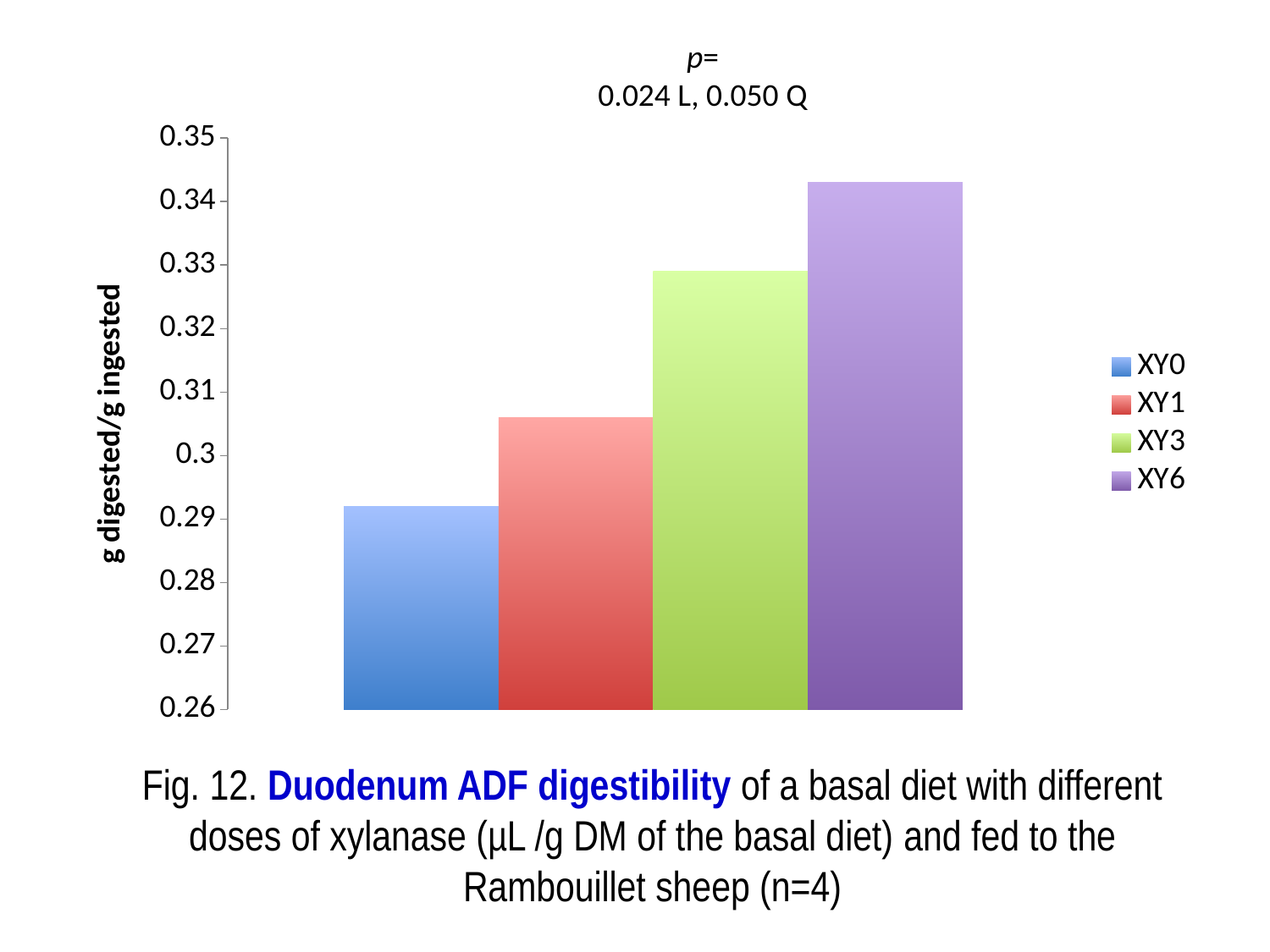
Which series has the highest duodenum ADF digestibility? XY6 How many series does the legend list? 4 Is the value for XY0 greater or less than 0.30? less Is the value for XY3 greater or less than 0.32? greater What kind of chart is shown on the slide? bar chart How many bars are plotted in the chart? 4 Is the value for XY6 greater or less than 0.33? greater Do the values rise or fall from XY0 to XY6 along the x axis? rise Which is larger, the value for XY1 or the value for XY3? XY3 Which series has the lowest duodenum ADF digestibility? XY0 What is the label of the y axis? g digested/g ingested